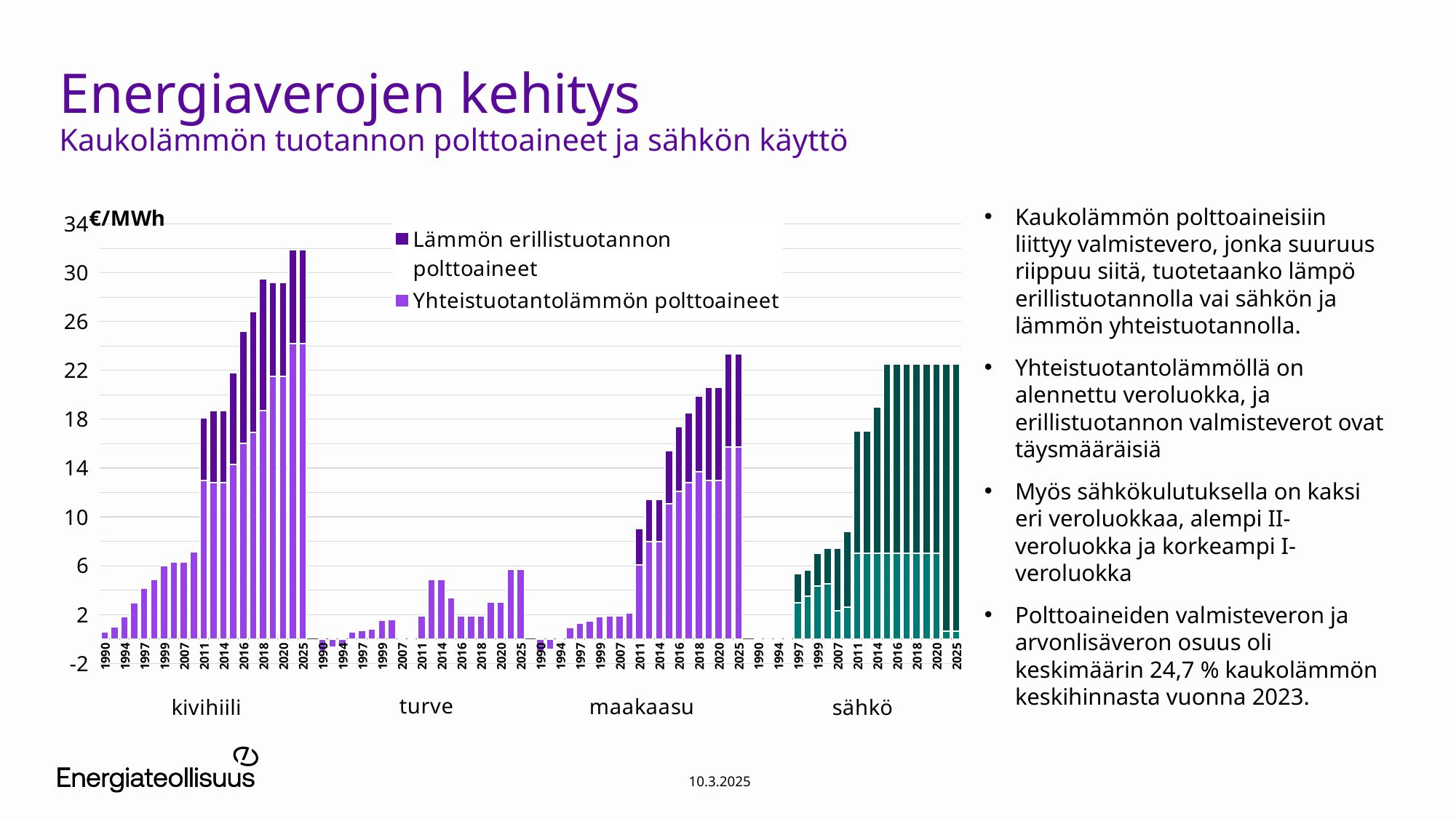
Is the value for turve in 2025 greater or less than 10? less What kind of chart is shown on the slide? bar chart Is the value for sähkö in 2025 greater or less than 18? greater Which fuel group has the highest bar in 2025? kivihiili How many series does the chart legend list? 2 How many fuel groups are labelled along the bottom of the chart? 4 Which is larger in 2025, the bar for kivihiili or the bar for turve? kivihiili Do the kivihiili values rise or fall from 1990 to 2025? rise What unit is shown on the chart's vertical axis? €/MWh Is the total value for kivihiili in 2011 greater or less than 14? greater